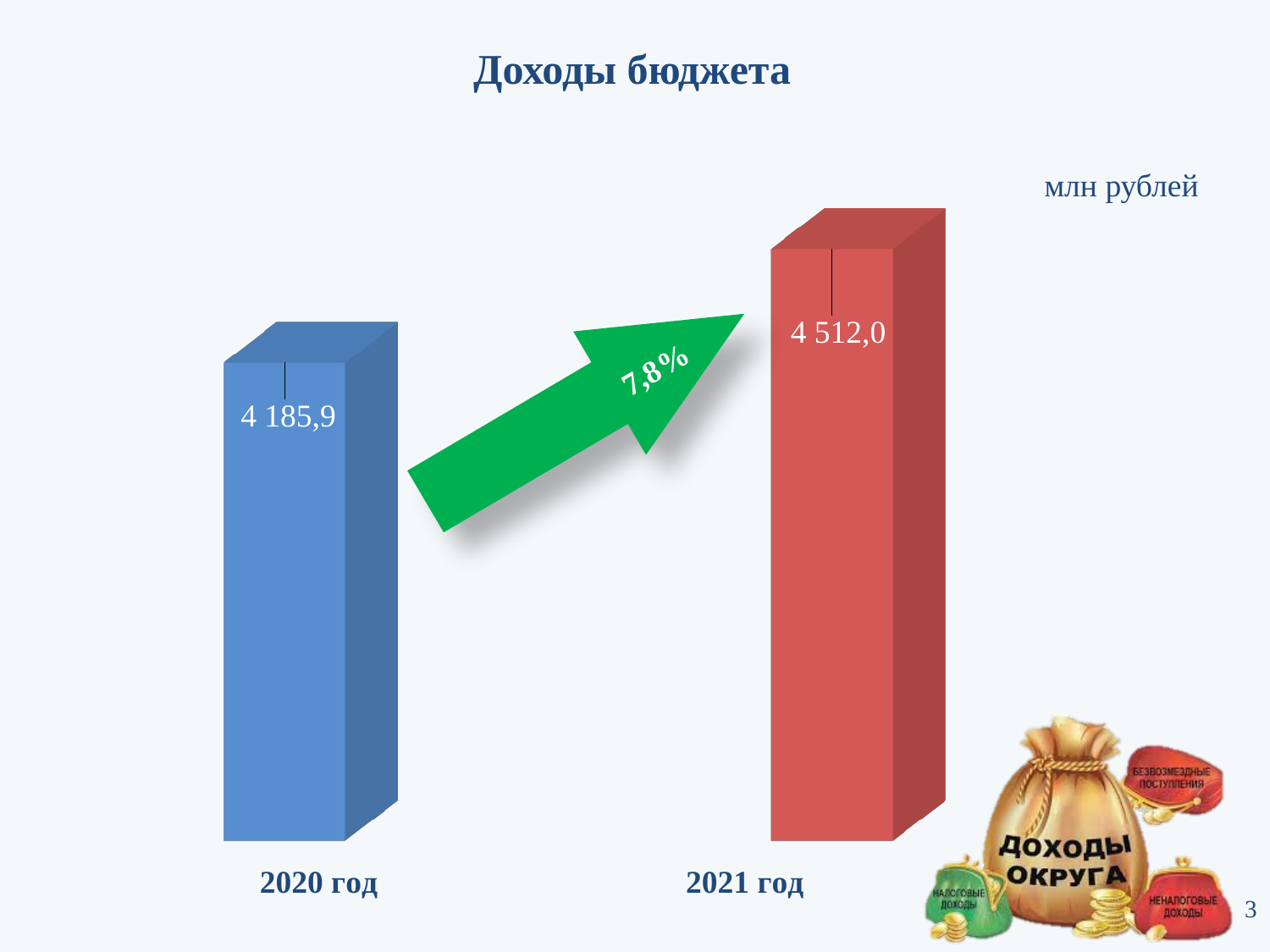
What is the title of the chart? Доходы бюджета Which year has the higher budget income? 2021 год What is the value for 2021 год? 4 512,0 Do the values rise or fall from 2020 год to 2021 год? rise What is the difference between the 2021 год and 2020 год values? 326,1 What unit is indicated for the chart values? млн рублей What kind of chart is shown on the slide? bar chart Is the value for 2021 год larger or smaller than the value for 2020 год? larger How many bars are shown in the chart? 2 Which year has the lower budget income? 2020 год What percentage growth is shown on the green arrow between the bars? 7,8% What is the value for 2020 год? 4 185,9